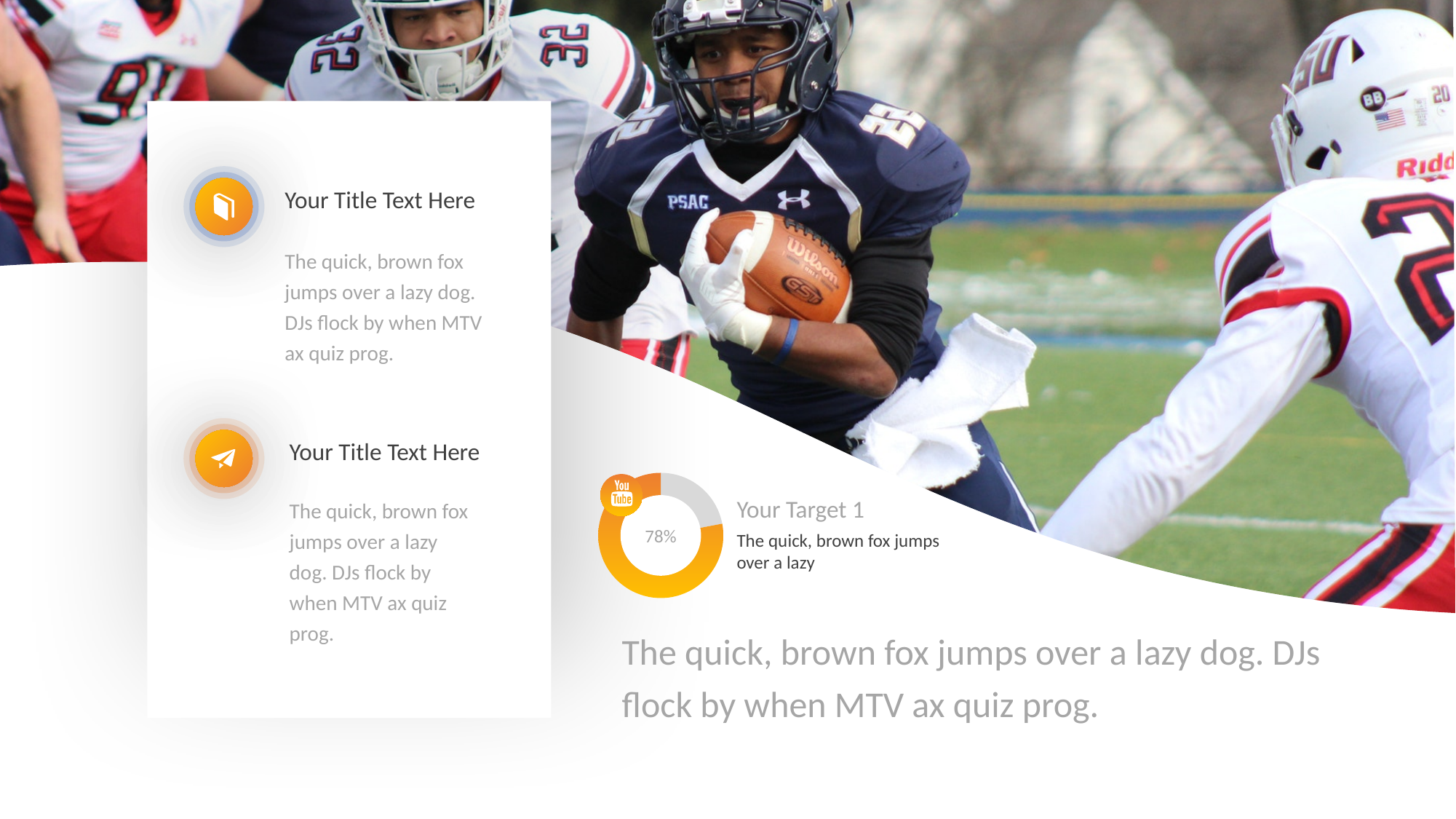
Which segment of the doughnut chart is larger, the orange one or the grey one? orange How many segments does the doughnut chart have? 2 Is the value shown in the doughnut chart greater or less than 50%? greater What kind of chart is shown next to the 'Your Target 1' text? doughnut chart What percentage is shown in the centre of the doughnut chart? 78% What target label is written next to the doughnut chart? Your Target 1 What share of the doughnut chart does the grey segment represent? 22% Which brand icon is placed on the doughnut chart? YouTube